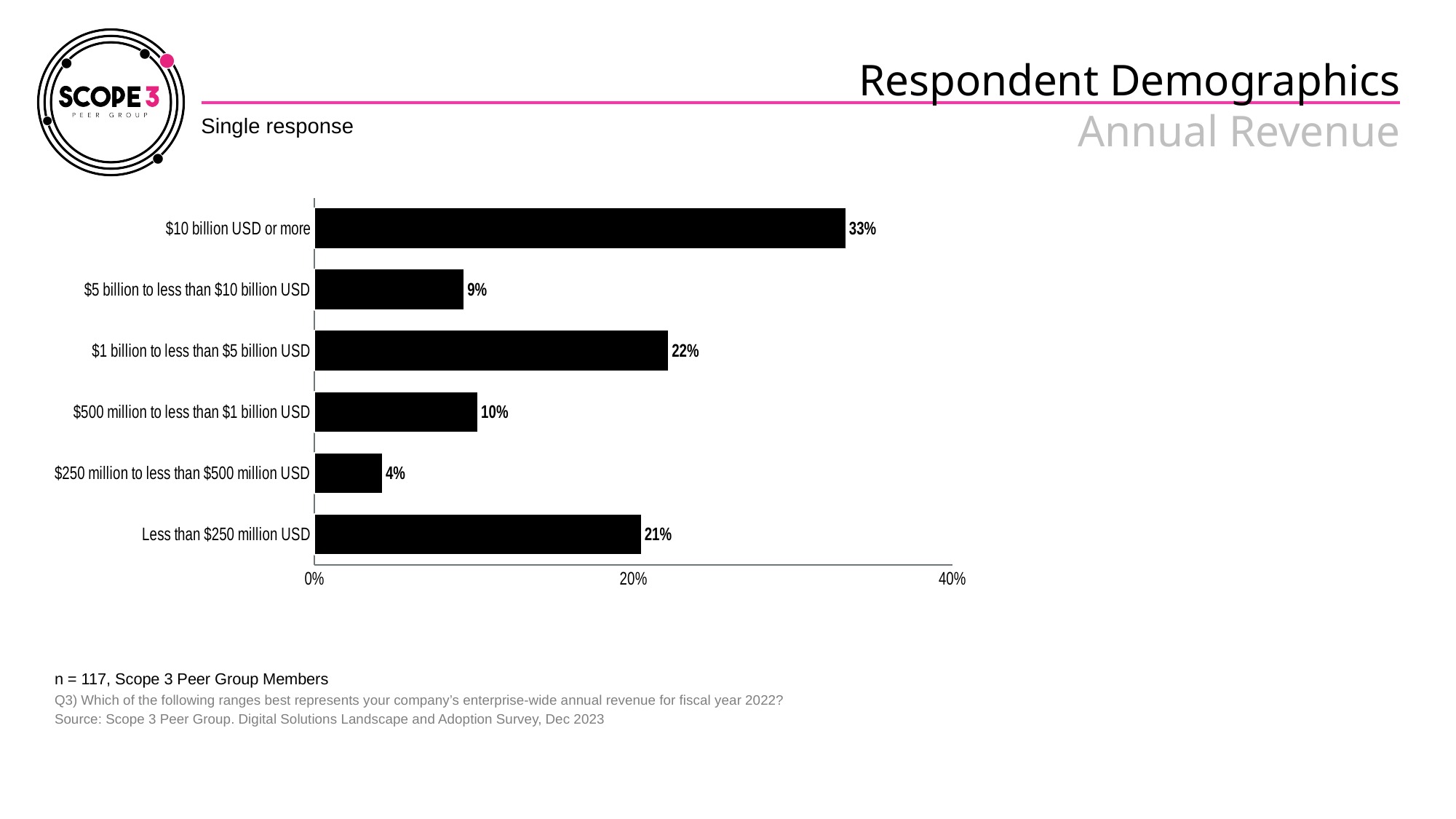
What is the maximum value shown on the horizontal axis? 40% What is the value for the $500 million to less than $1 billion USD category? 10% What is the difference in percentage points between the $10 billion USD or more category and the $1 billion to less than $5 billion USD category? 11 What percentage of respondents reported annual revenue of $10 billion USD or more? 33% Which is larger: the value for $5 billion to less than $10 billion USD or the value for $500 million to less than $1 billion USD? $500 million to less than $1 billion USD What type of chart is shown on the slide? bar chart Which revenue category has the lowest share of respondents? $250 million to less than $500 million USD Is the value for $1 billion to less than $5 billion USD greater or less than 20%? greater What is the sample size (n) stated on the slide? 117 What percentage of respondents reported annual revenue of less than $250 million USD? 21% How many revenue categories are shown in the chart? 6 Which revenue category has the highest share of respondents? $10 billion USD or more